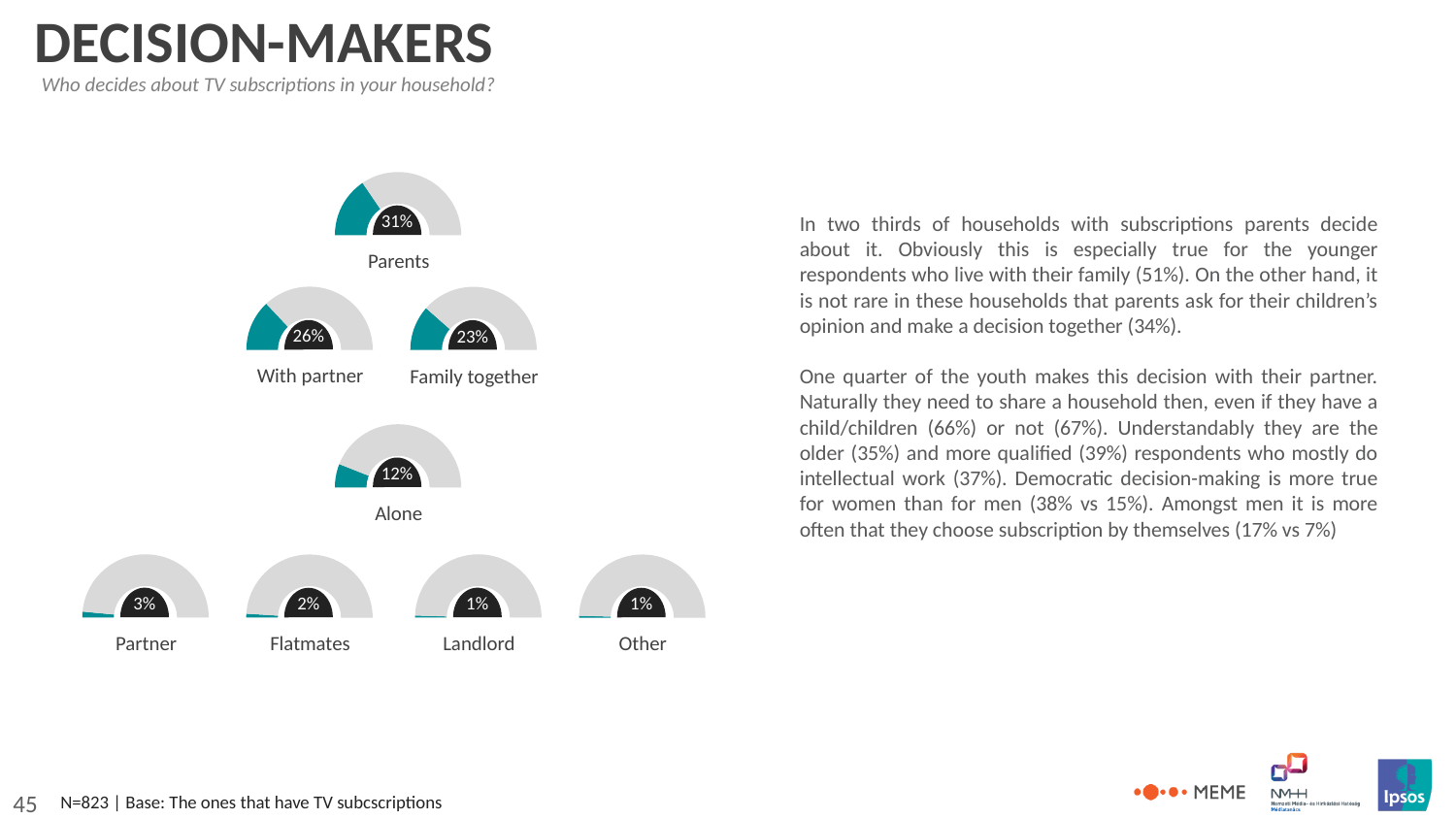
Which category has the highest value on the slide? Parents Which is larger, the value for 'Partner' or the value for 'Flatmates'? Partner What is the sample size (N) stated at the bottom of the slide? N=823 What is the value shown for 'Family together'? 23% What percentage of respondents decide about TV subscriptions alone? 12% How many categories are shown in the gauge charts on the slide? 8 What is the difference between the values for 'With partner' and 'Family together'? 3% What is the difference between the values for 'Parents' and 'Alone'? 19% What percentage of households say parents decide about TV subscriptions? 31% What is the value shown for 'Flatmates'? 2% What kind of chart is used to display each category's value? Gauge (semi-circular doughnut) chart What is the value shown for 'With partner'? 26%